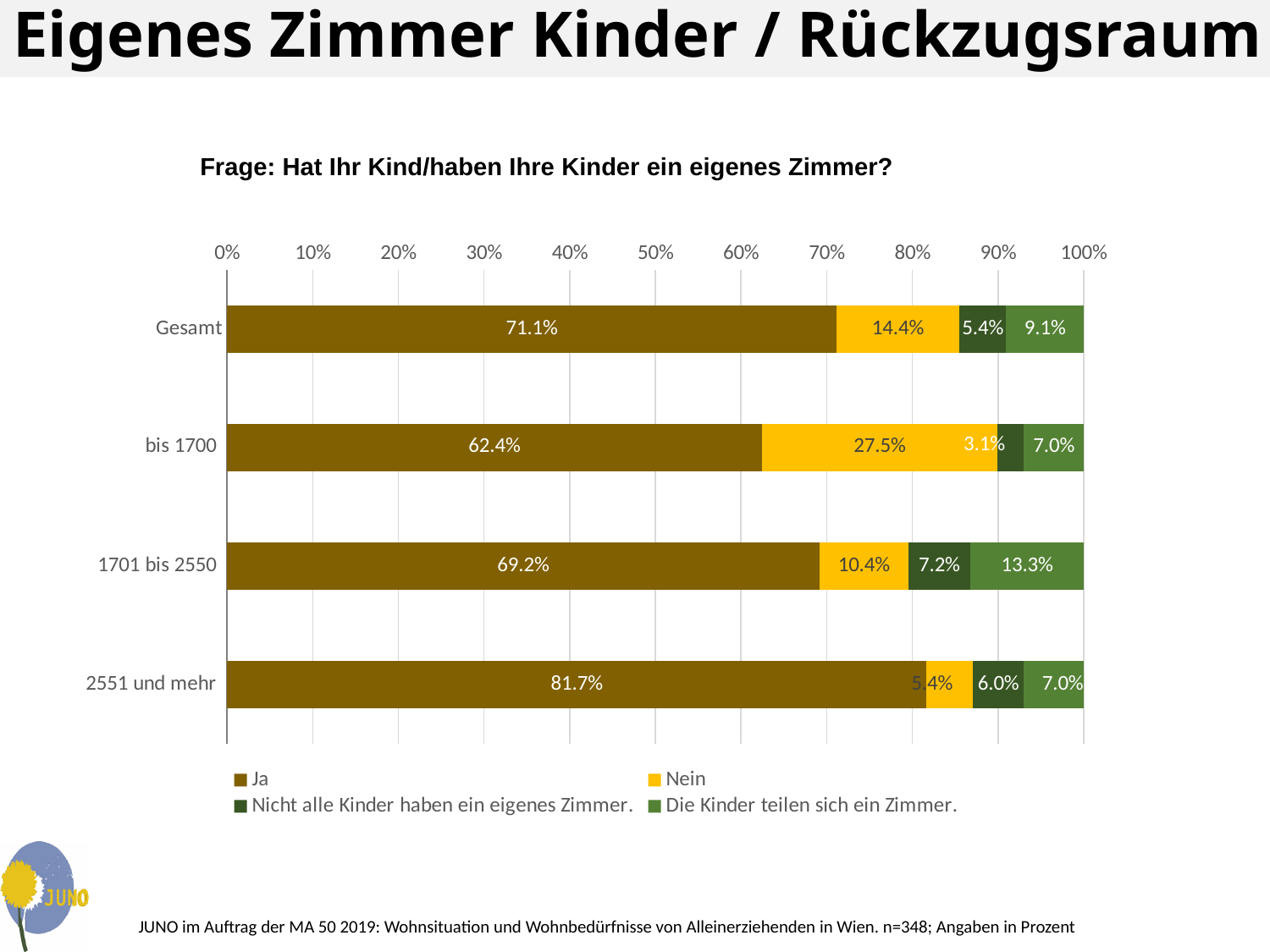
What question is stated above the chart? Frage: Hat Ihr Kind/haben Ihre Kinder ein eigenes Zimmer? What is the value for "Ja" in the "Gesamt" category? 71.1% How many series does the legend list? 4 What is the value for "Die Kinder teilen sich ein Zimmer." in the "1701 bis 2550" category? 13.3% Which category has the lowest value for "Ja"? bis 1700 What kind of chart is shown on the slide? Stacked bar chart What is the difference between the "Ja" values for "2551 und mehr" and "bis 1700"? 19.3% What is the value for "Nicht alle Kinder haben ein eigenes Zimmer." in the "2551 und mehr" category? 6.0% What is the value for "Nein" in the "bis 1700" category? 27.5% Which category has the highest value for "Ja"? 2551 und mehr Which is larger: the "Nein" value for "Gesamt" or for "1701 bis 2550"? Gesamt How many categories are shown on the y axis? 4